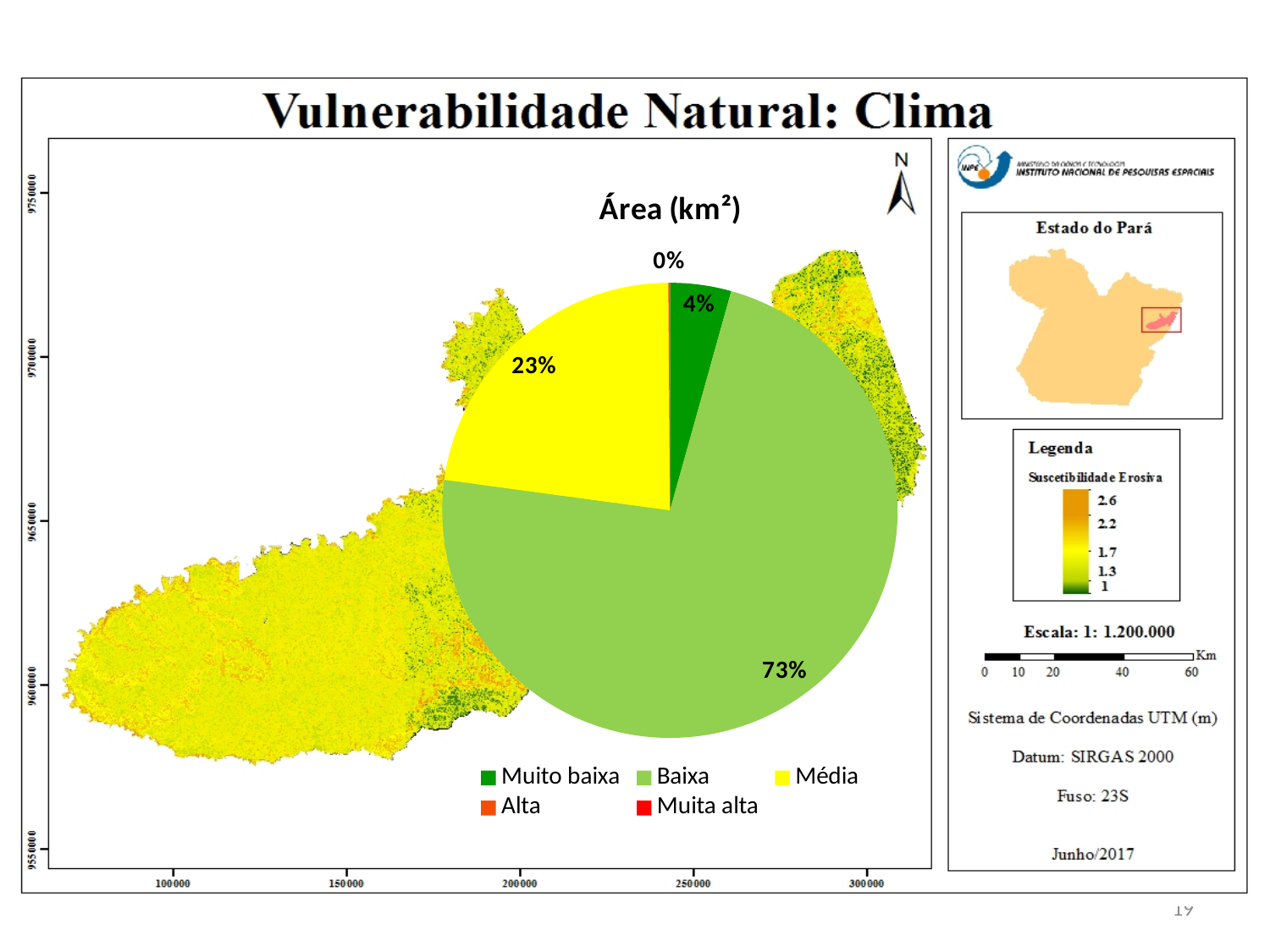
What share of the pie does the Muito baixa category have? 4% What share of the pie does the Média category have? 23% Which category has the largest slice of the pie? Baixa What share of the pie does the Baixa category have? 73% By how many percentage points does the Baixa share exceed the Média share? 50 percentage points What is the title of the pie chart? Área (km²) What kind of chart is shown on the slide? pie chart What colour represents the Média category in the pie chart? yellow Which slice is larger, Média or Muito baixa? Média What is the combined share of the Baixa and Média slices? 96% By how many percentage points does the Média share exceed the Muito baixa share? 19 percentage points How many categories does the pie chart's legend list? 5